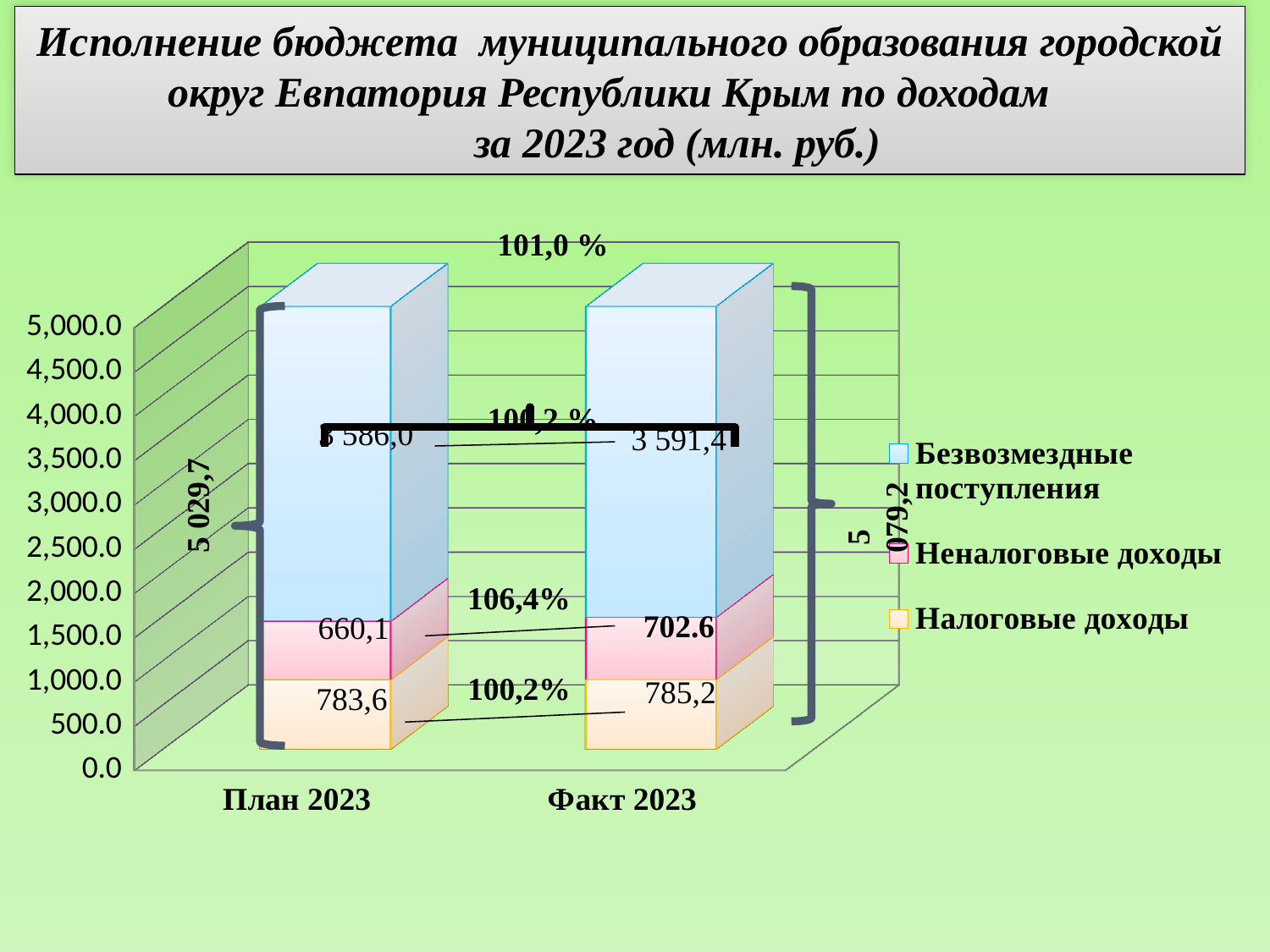
What is the value of Налоговые доходы for Факт 2023? 785,2 What is the value of Неналоговые доходы for План 2023? 660,1 What is the value of Налоговые доходы for План 2023? 783,6 What kind of chart is shown on the slide? stacked bar chart What percentage label is shown between the Неналоговые доходы segments of the two bars? 106,4% How many series does the chart legend list? 3 How many categories are shown on the x axis of the chart? 2 What is the value of Безвозмездные поступления for Факт 2023? 3 591,4 Which category has the larger value for Неналоговые доходы, План 2023 or Факт 2023? Факт 2023 What is the total of the stacked bar for План 2023? 5 029,7 What is the difference between the Неналоговые доходы values for Факт 2023 and План 2023? 42,5 What is the value of Неналоговые доходы for Факт 2023? 702.6